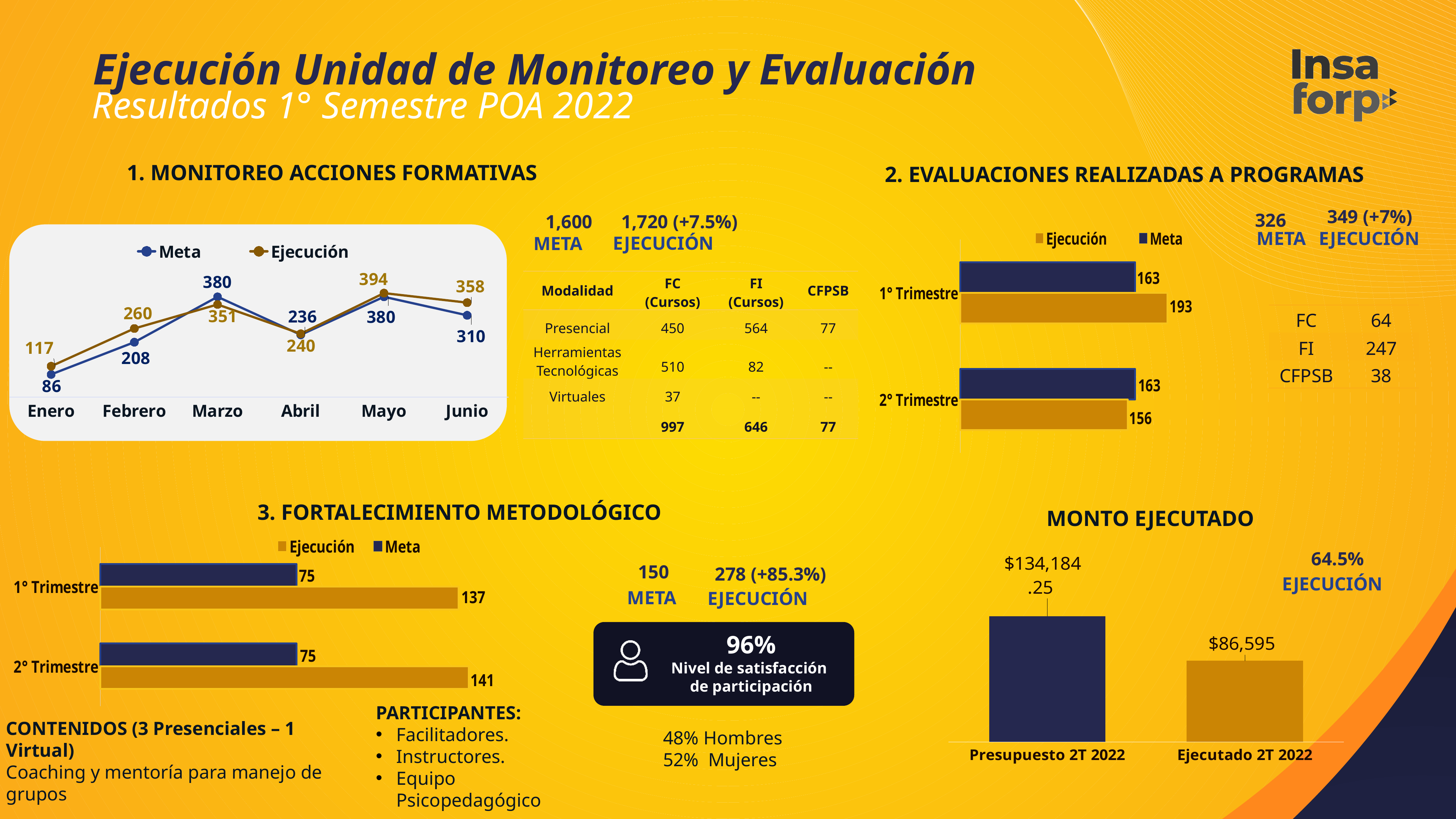
In the "MONTO EJECUTADO" chart, what is the value for Ejecutado 2T 2022? $86,595 In the line chart under "1. MONITOREO ACCIONES FORMATIVAS", what is the Meta value for Febrero? 208 In the bar chart under "2. EVALUACIONES REALIZADAS A PROGRAMAS", which is larger for 2° Trimestre, Meta or Ejecución? Meta In the line chart under "1. MONITOREO ACCIONES FORMATIVAS", what is the difference between Ejecución and Meta in Junio? 48 In the bar chart under "3. FORTALECIMIENTO METODOLÓGICO", what is the difference between Ejecución and Meta in 1° Trimestre? 62 In the bar chart under "3. FORTALECIMIENTO METODOLÓGICO", what is the Ejecución value for 2° Trimestre? 141 In the line chart under "1. MONITOREO ACCIONES FORMATIVAS", which month has the lowest Meta value? Enero In the line chart under "1. MONITOREO ACCIONES FORMATIVAS", how many months are plotted on the x axis? 6 In the line chart under "1. MONITOREO ACCIONES FORMATIVAS", what type of chart is used? Line chart In the bar chart under "3. FORTALECIMIENTO METODOLÓGICO", how many series does the legend list? 2 In the line chart under "1. MONITOREO ACCIONES FORMATIVAS", what is the Ejecución value for Mayo? 394 In the bar chart under "2. EVALUACIONES REALIZADAS A PROGRAMAS", what is the Ejecución value for 1° Trimestre? 193